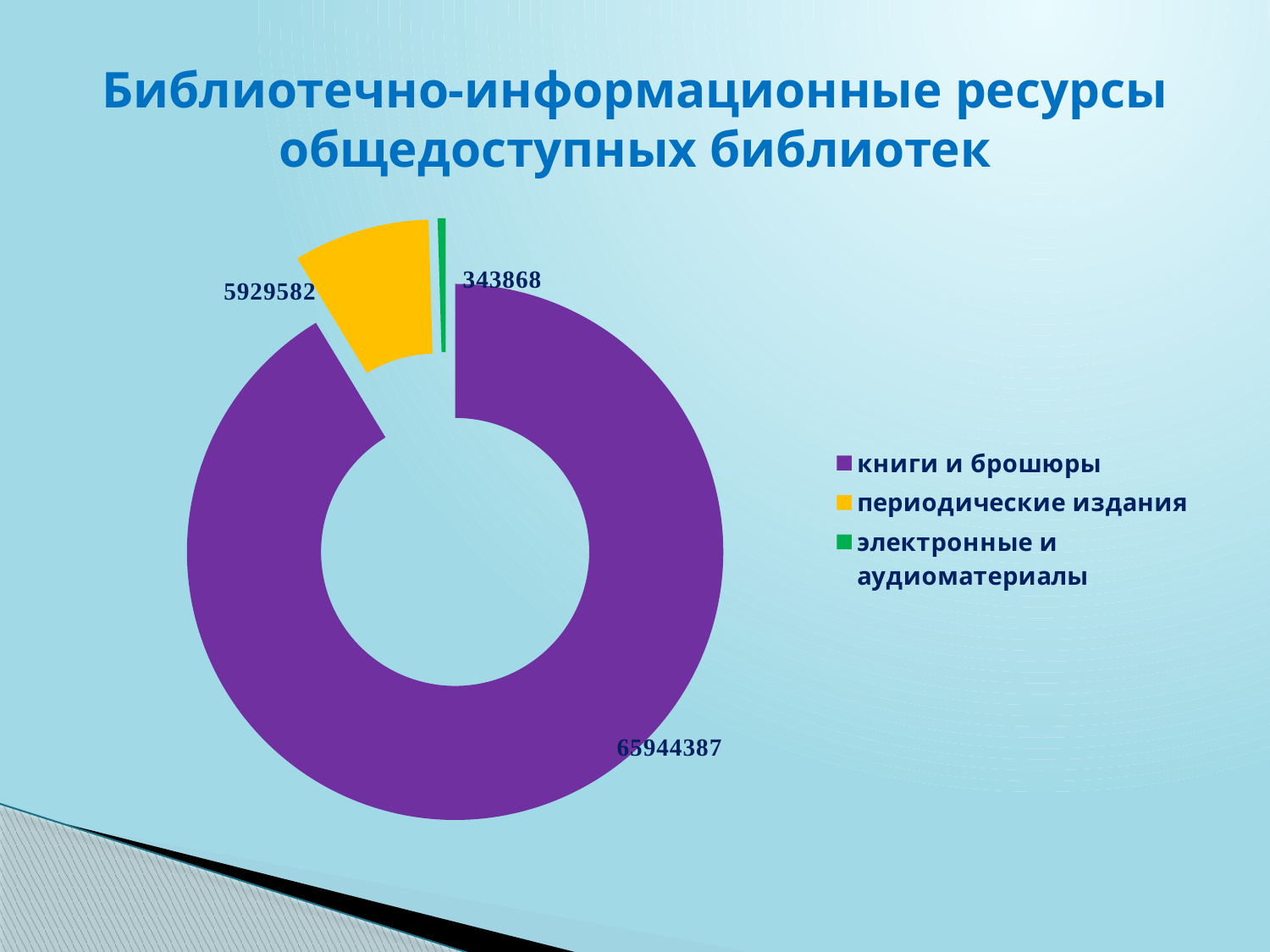
What is the total of all three categories? 72217837 Which is larger, периодические издания or электронные и аудиоматериалы? периодические издания What kind of chart is shown on the slide? doughnut chart Which category has the largest value? книги и брошюры What is the value for периодические издания? 5929582 Which category has the smallest value? электронные и аудиоматериалы What is the difference between the values for книги и брошюры and периодические издания? 60014805 What is the value for книги и брошюры? 65944387 What is the difference between the values for периодические издания and электронные и аудиоматериалы? 5585714 What is the title of the slide? Библиотечно-информационные ресурсы общедоступных библиотек What is the value for электронные и аудиоматериалы? 343868 How many categories does the chart show? 3